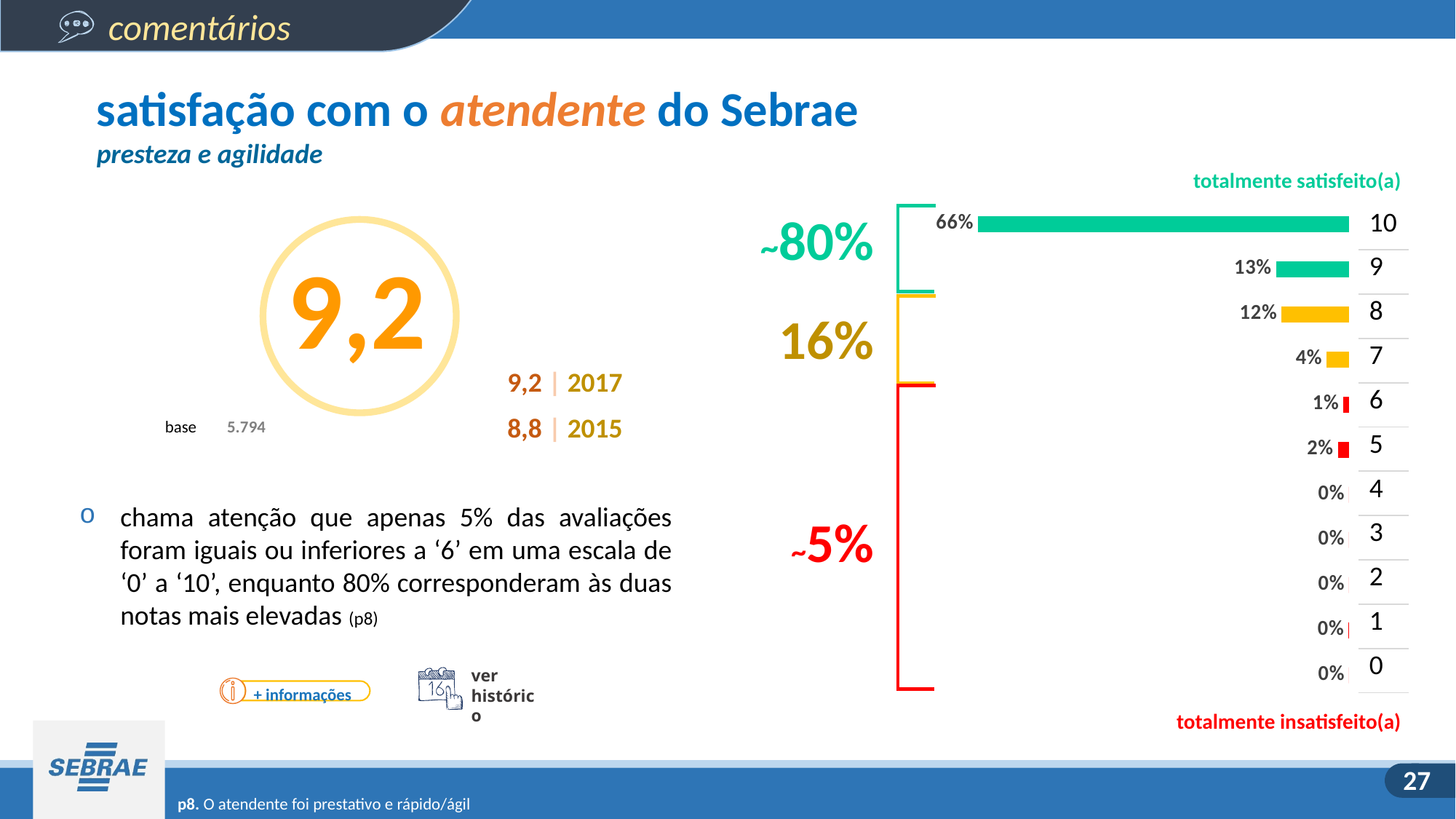
What is the difference in percentage points between the share giving a score of 10 and the share giving a score of 9? 53 Which score has a larger share of respondents, 9 or 8? 9 What percentage of respondents gave a score of 9? 13% What percentage of respondents gave a score of 10? 66% What kind of chart is used to show the distribution of scores? bar chart How many score categories are shown on the bar chart? 11 Which score has a larger share of respondents, 6 or 5? 5 What percentage of respondents gave a score of 5? 2% Which score has the highest percentage of respondents? 10 What percentage of respondents gave a score of 8? 12% What percentage of respondents gave a score of 7? 4% What is the combined percentage for scores 10 and 9? 79%